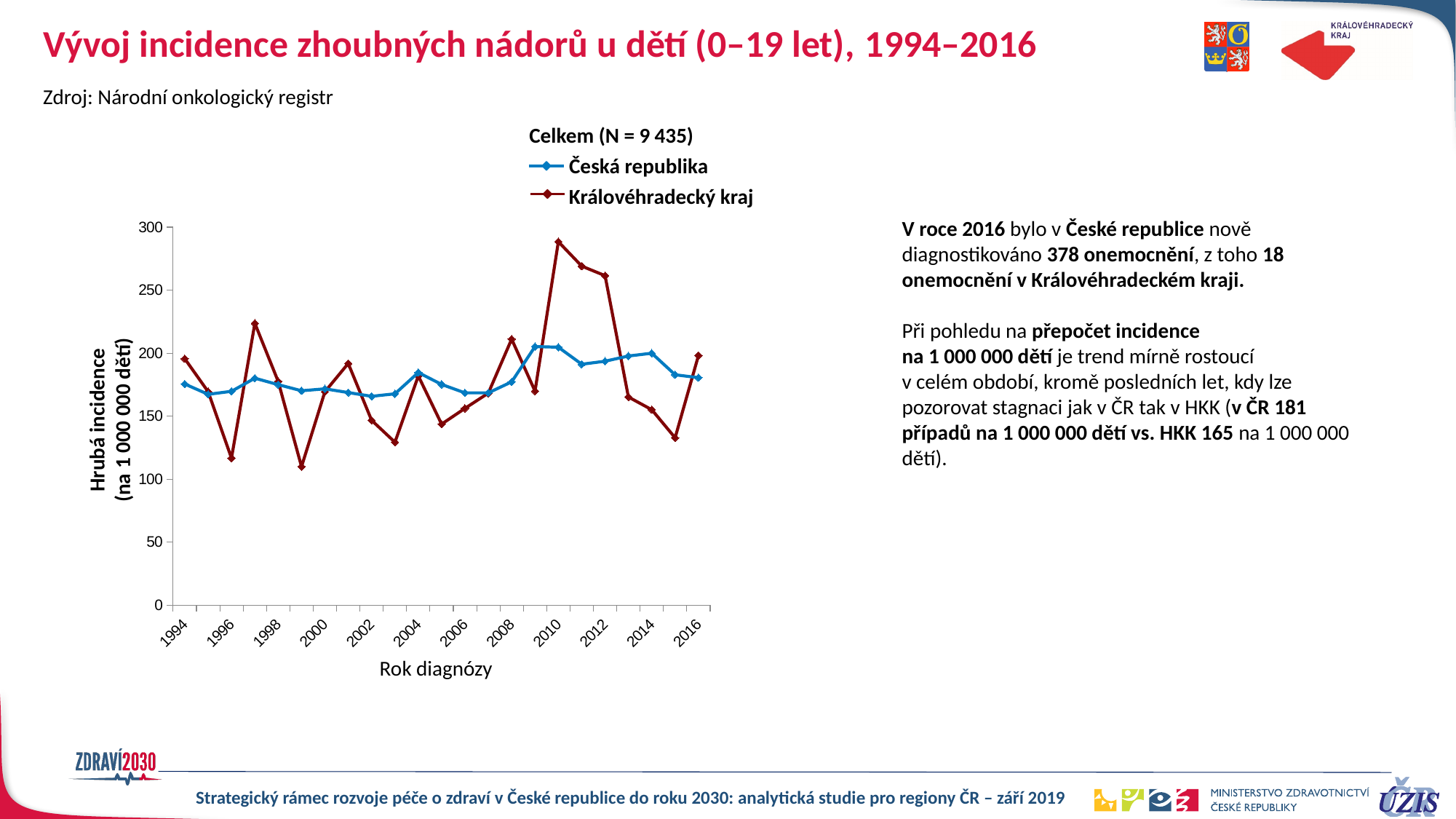
In 2010, which series has the higher value, Česká republika or Královéhradecký kraj? Královéhradecký kraj What kind of chart is shown on the slide? line chart Is the value for Královéhradecký kraj in 1997 greater or less than 200? greater How many series does the chart legend list? 2 Is the value for Královéhradecký kraj in 2010 greater or less than 250? greater What is the label of the x axis of the chart? Rok diagnózy Is the value for Královéhradecký kraj in 1999 greater or less than 150? less Does the Královéhradecký kraj series rise or fall between 2012 and 2013? fall In 1996, which series has the higher value, Česká republika or Královéhradecký kraj? Česká republika Which two series are shown in the chart legend? Česká republika and Královéhradecký kraj In which year does the Královéhradecký kraj series reach its highest value? 2010